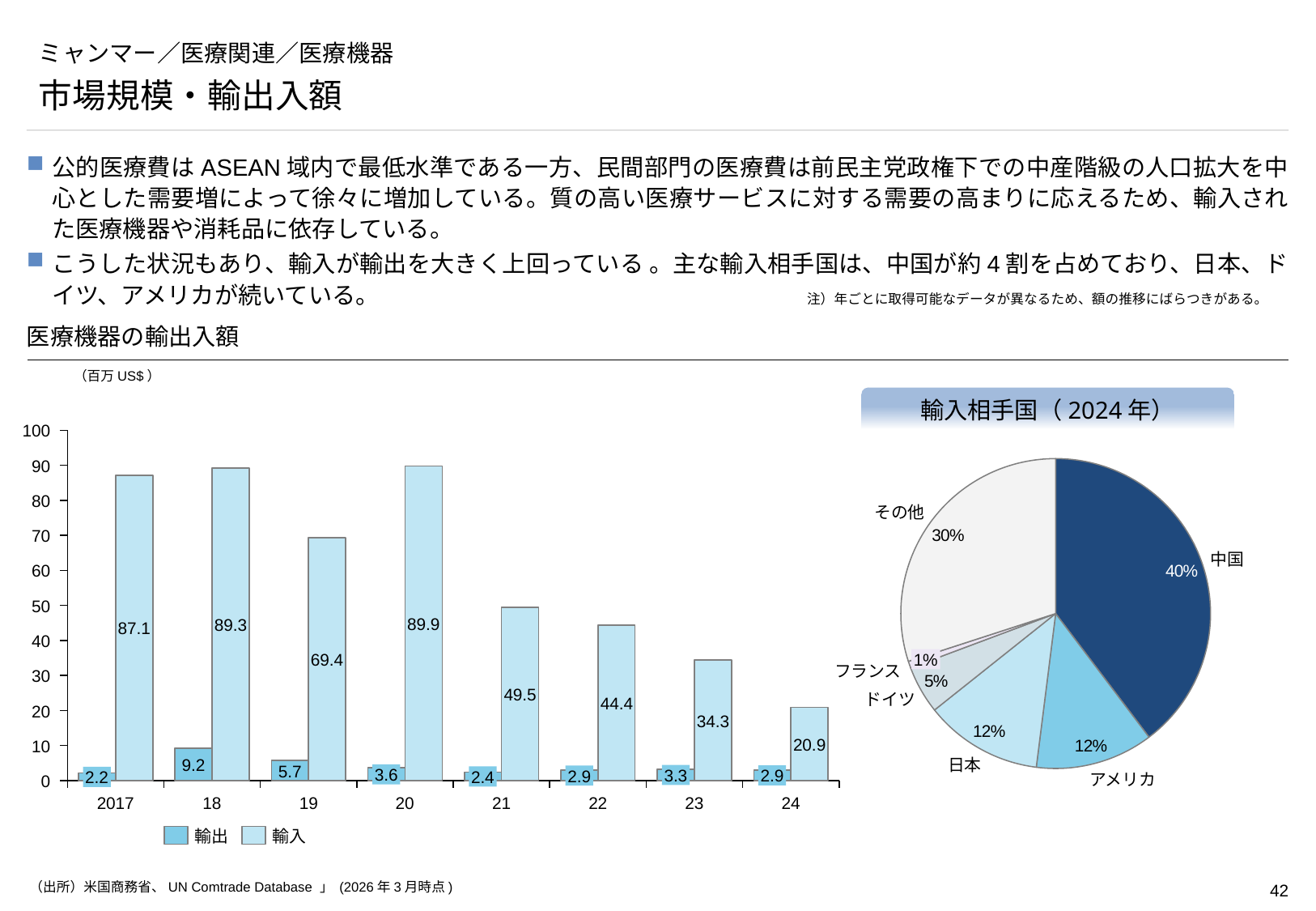
In the bar chart 医療機器の輸出入額, what is the difference between the 輸入 values for 20 and 21? 40.4 In the bar chart 医療機器の輸出入額, which year has the highest 輸入 value? 20 In the bar chart 医療機器の輸出入額, how many series does the legend list? 2 In the bar chart 医療機器の輸出入額, which year has the lowest 輸出 value? 2017 In the bar chart 医療機器の輸出入額, what is the 輸入 value for 2017? 87.1 In the bar chart 医療機器の輸出入額, what is the 輸出 value for 18? 9.2 In the bar chart 医療機器の輸出入額, how many years are shown on the x axis? 8 In the bar chart 医療機器の輸出入額, what is the 輸入 value for 24? 20.9 In the pie chart 輸入相手国（2024年）, what share does 中国 have? 40% What kind of chart is 輸入相手国（2024年）? Pie chart In the bar chart 医療機器の輸出入額, is the 輸入 value for 22 larger than the 輸入 value for 23? Yes, 22 In the pie chart 輸入相手国（2024年）, which country has the smallest share? フランス